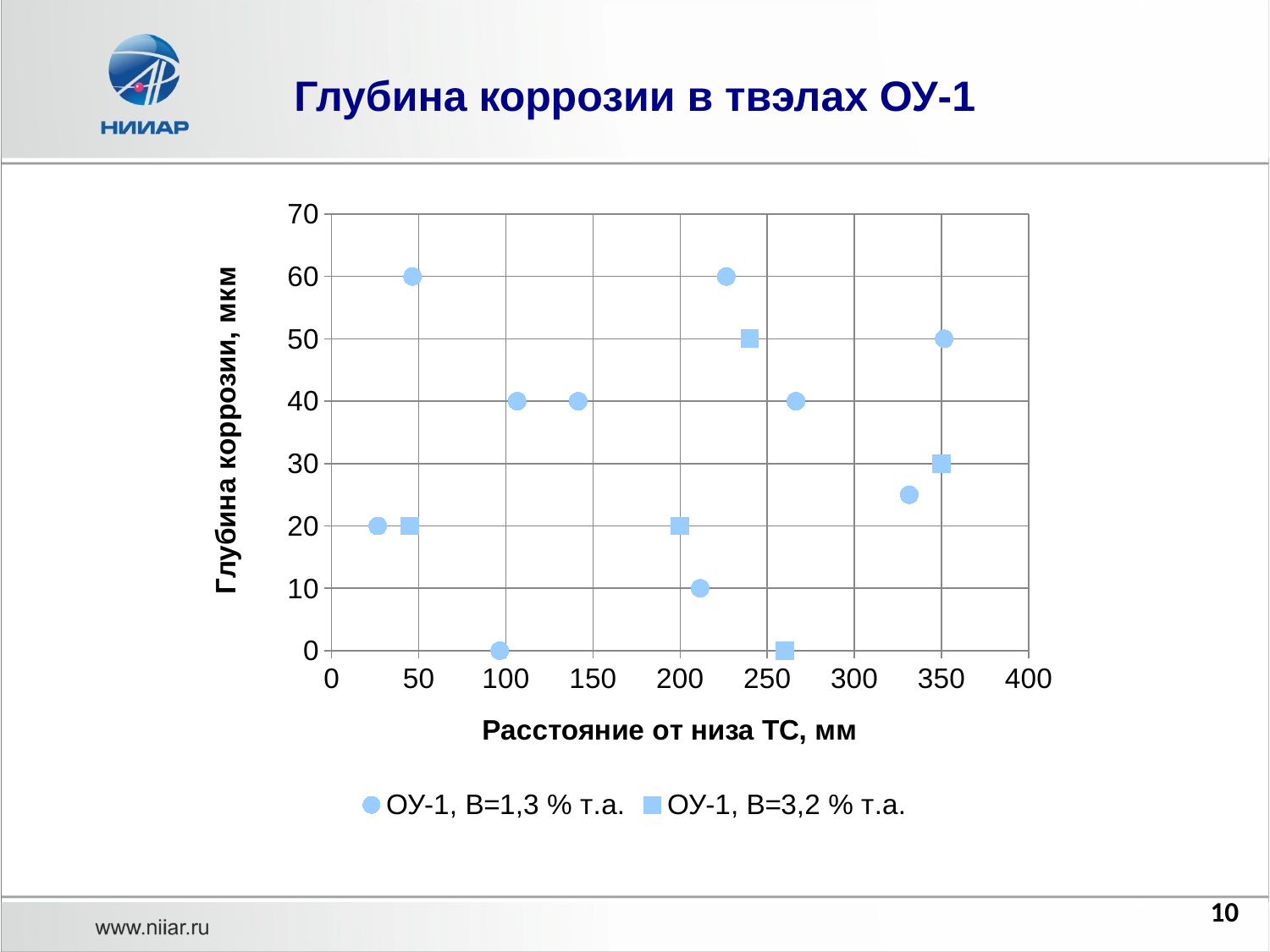
How many points are plotted for the series ОУ-1, В=3,2 % т.а.? 5 What is the highest corrosion depth reached by the series ОУ-1, В=3,2 % т.а.? 50 How many points are plotted for the series ОУ-1, В=1,3 % т.а.? 10 What is the title of the chart's x axis? Расстояние от низа ТС, мм Which series reaches the higher maximum corrosion depth, ОУ-1, В=1,3 % т.а. or ОУ-1, В=3,2 % т.а.? ОУ-1, В=1,3 % т.а. What is the title of the chart's y axis? Глубина коррозии, мкм What is the highest corrosion depth reached by the series ОУ-1, В=1,3 % т.а.? 60 What is the lowest corrosion depth reached by the series ОУ-1, В=3,2 % т.а.? 0 How many series does the legend list? 2 Is the corrosion depth of the ОУ-1, В=1,3 % т.а. point located near 350 mm greater or less than 40? greater What kind of chart is shown on the slide? scatter chart Is the corrosion depth of the ОУ-1, В=3,2 % т.а. point located near 350 mm greater or less than 40? less